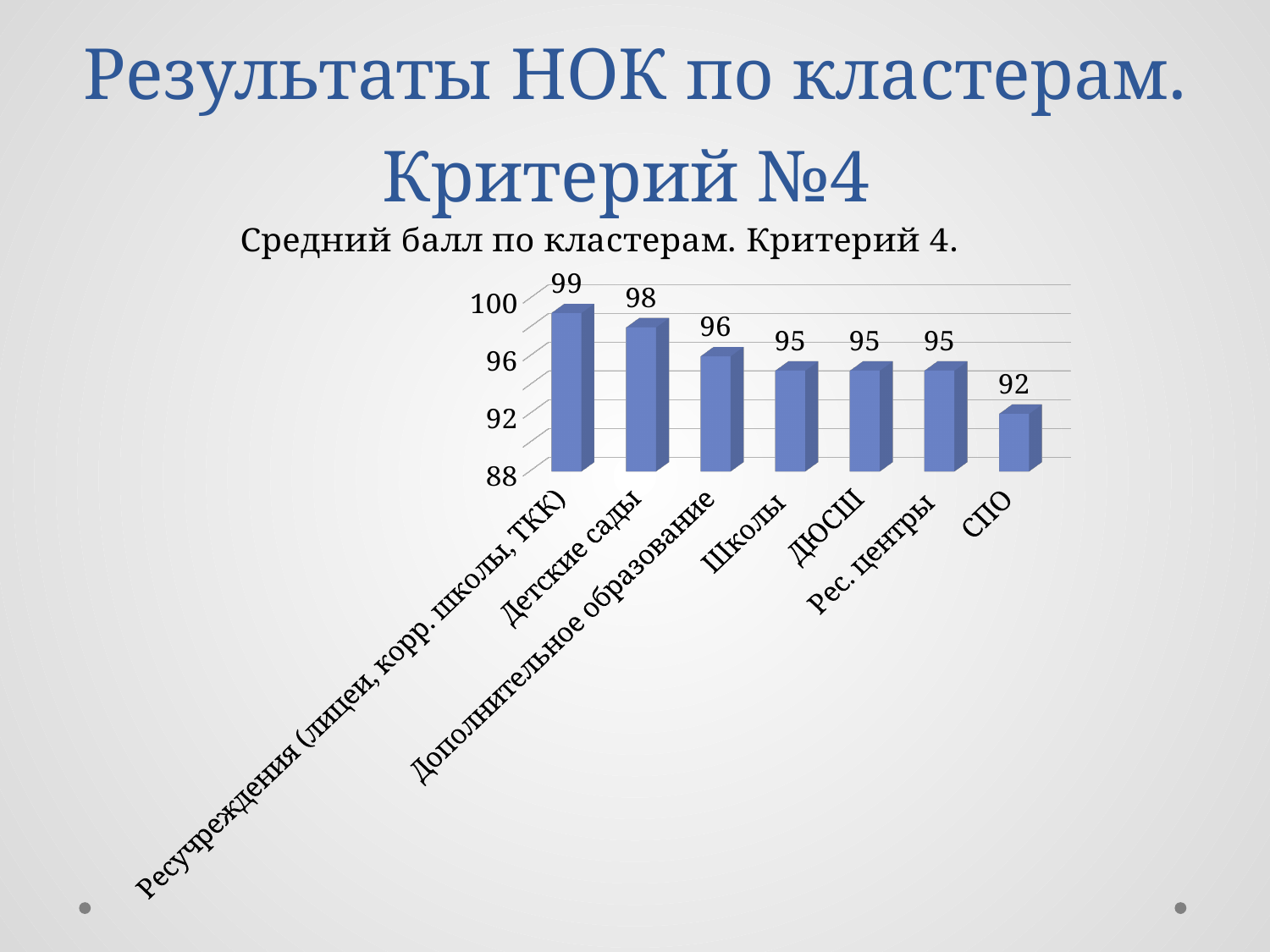
What is the value for Детские сады? 98 Which category has the highest value? Ресучреждения (лицеи, корр. школы, ТКК) What kind of chart is shown on the slide? bar chart Do the values rise or fall from left to right along the x axis? fall How many categories are shown in the chart? 7 What is the value for СПО? 92 Which category has the lowest value? СПО Is the value for ДЮСШ greater or less than 92? greater What is the difference between the values for Ресучреждения (лицеи, корр. школы, ТКК) and СПО? 7 What is the value for Дополнительное образование? 96 What is the title of the chart? Средний балл по кластерам. Критерий 4. Which is larger, the value for Детские сады or the value for Школы? Детские сады